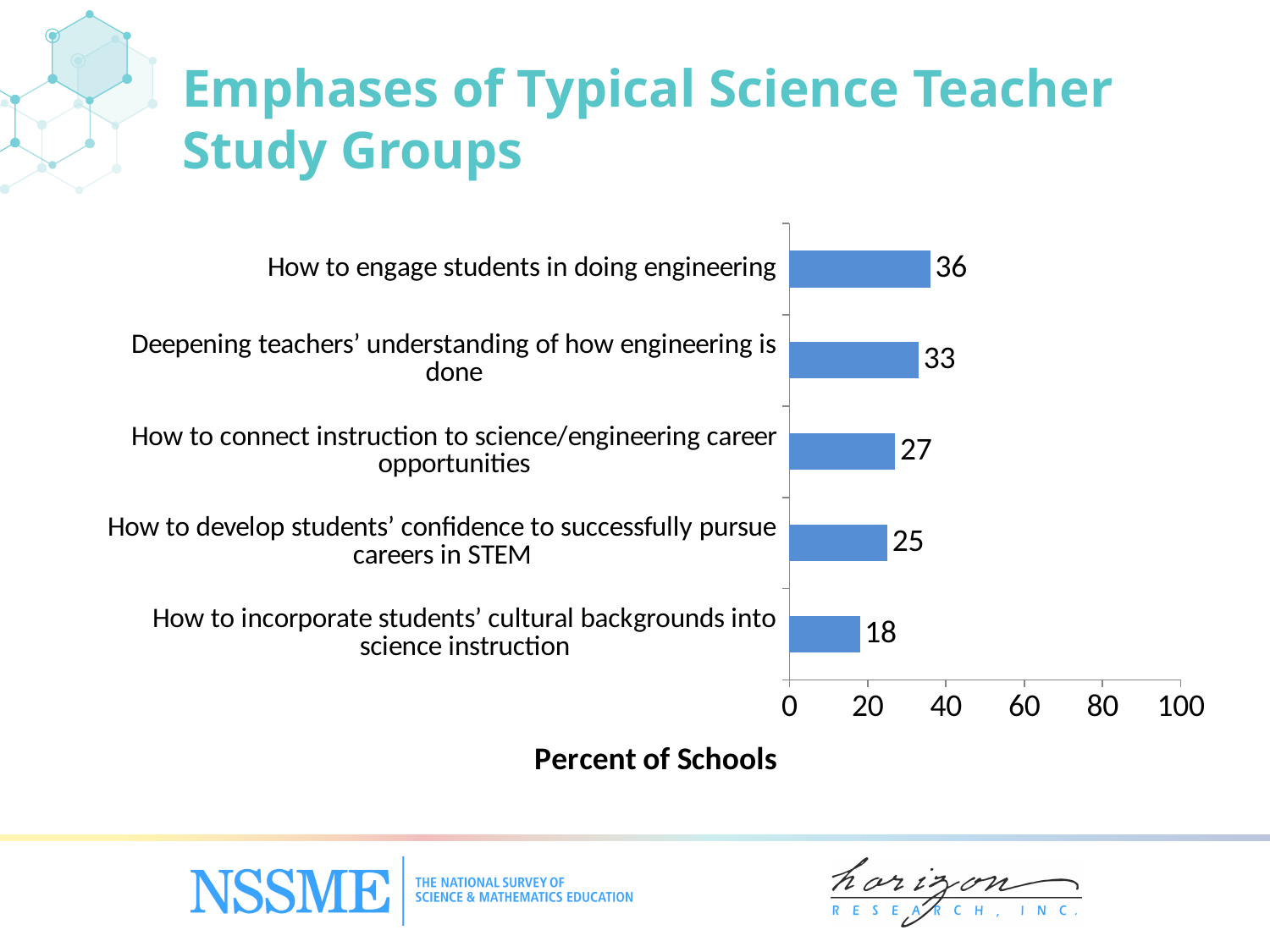
Which is larger: the value for 'How to connect instruction to science/engineering career opportunities' or 'How to develop students' confidence to successfully pursue careers in STEM'? How to connect instruction to science/engineering career opportunities How many categories are shown in the chart? 5 What is the value for 'How to connect instruction to science/engineering career opportunities'? 27 What is the difference between the values for 'How to develop students' confidence to successfully pursue careers in STEM' and 'How to incorporate students' cultural backgrounds into science instruction'? 7 What is the label of the horizontal axis? Percent of Schools What kind of chart is shown on the slide? bar chart What is the value for 'How to incorporate students' cultural backgrounds into science instruction'? 18 What percent of schools reported study groups emphasizing how to engage students in doing engineering? 36 Is the value for 'Deepening teachers' understanding of how engineering is done' greater or less than 40? less Which emphasis has the lowest percent of schools? How to incorporate students' cultural backgrounds into science instruction What is the difference between the values for 'How to engage students in doing engineering' and 'Deepening teachers' understanding of how engineering is done'? 3 Which emphasis has the highest percent of schools? How to engage students in doing engineering